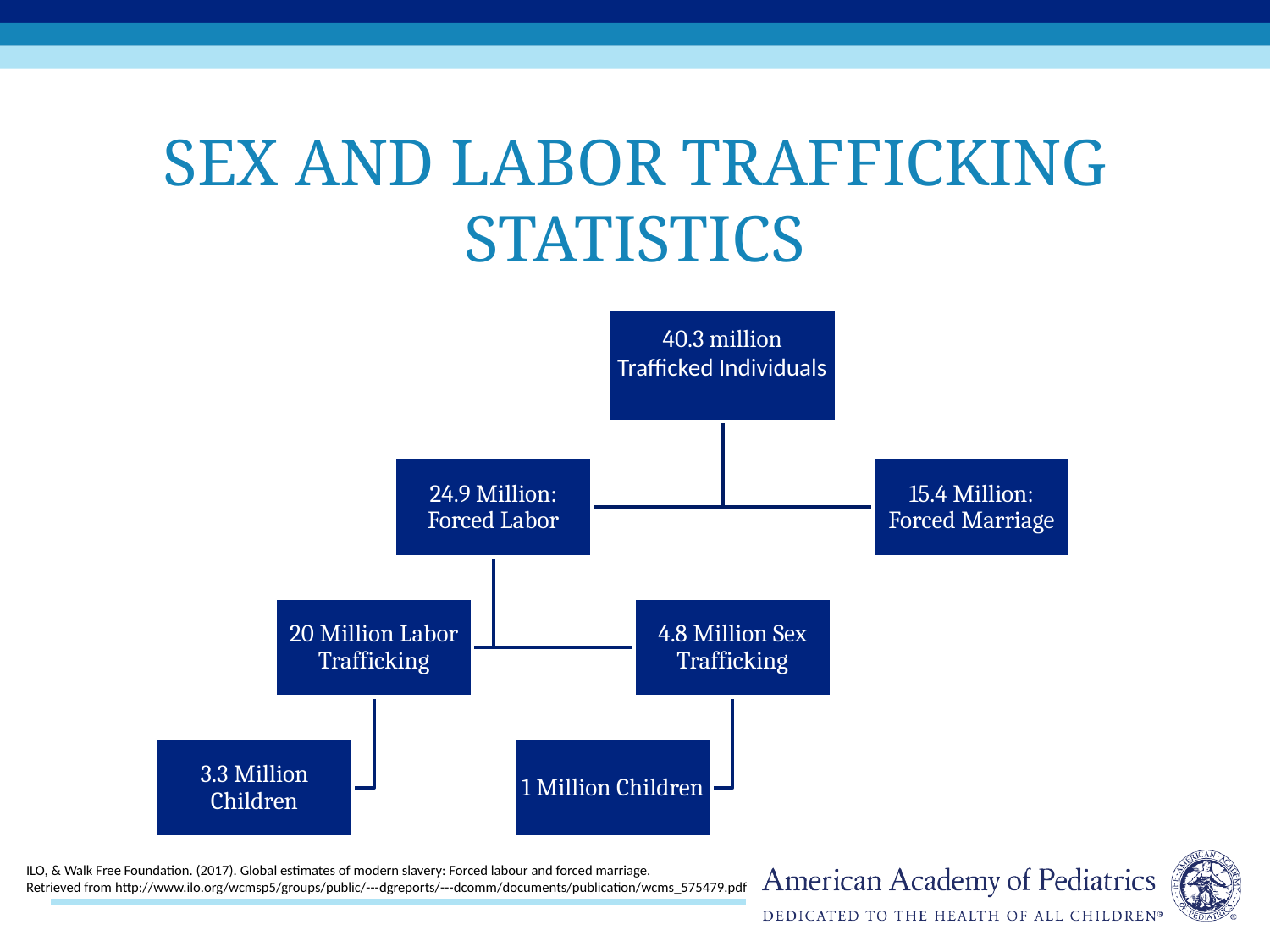
What figure is given for Forced Labor? 24.9 Million How many trafficked individuals does the top box of the diagram report? 40.3 million What figure is given for Sex Trafficking? 4.8 Million What is the difference between the Labor Trafficking figure and the Sex Trafficking figure? 15.2 Million How many children are reported under Sex Trafficking? 1 Million What figure is given for Forced Marriage? 15.4 Million How many boxes does the diagram contain? 7 Which is larger, the Forced Labor figure or the Forced Marriage figure? Forced Labor What is the title of the slide? SEX AND LABOR TRAFFICKING STATISTICS What is the difference between the Forced Labor figure and the Forced Marriage figure? 9.5 Million What figure is given for Labor Trafficking? 20 Million How many children are reported under Labor Trafficking? 3.3 Million